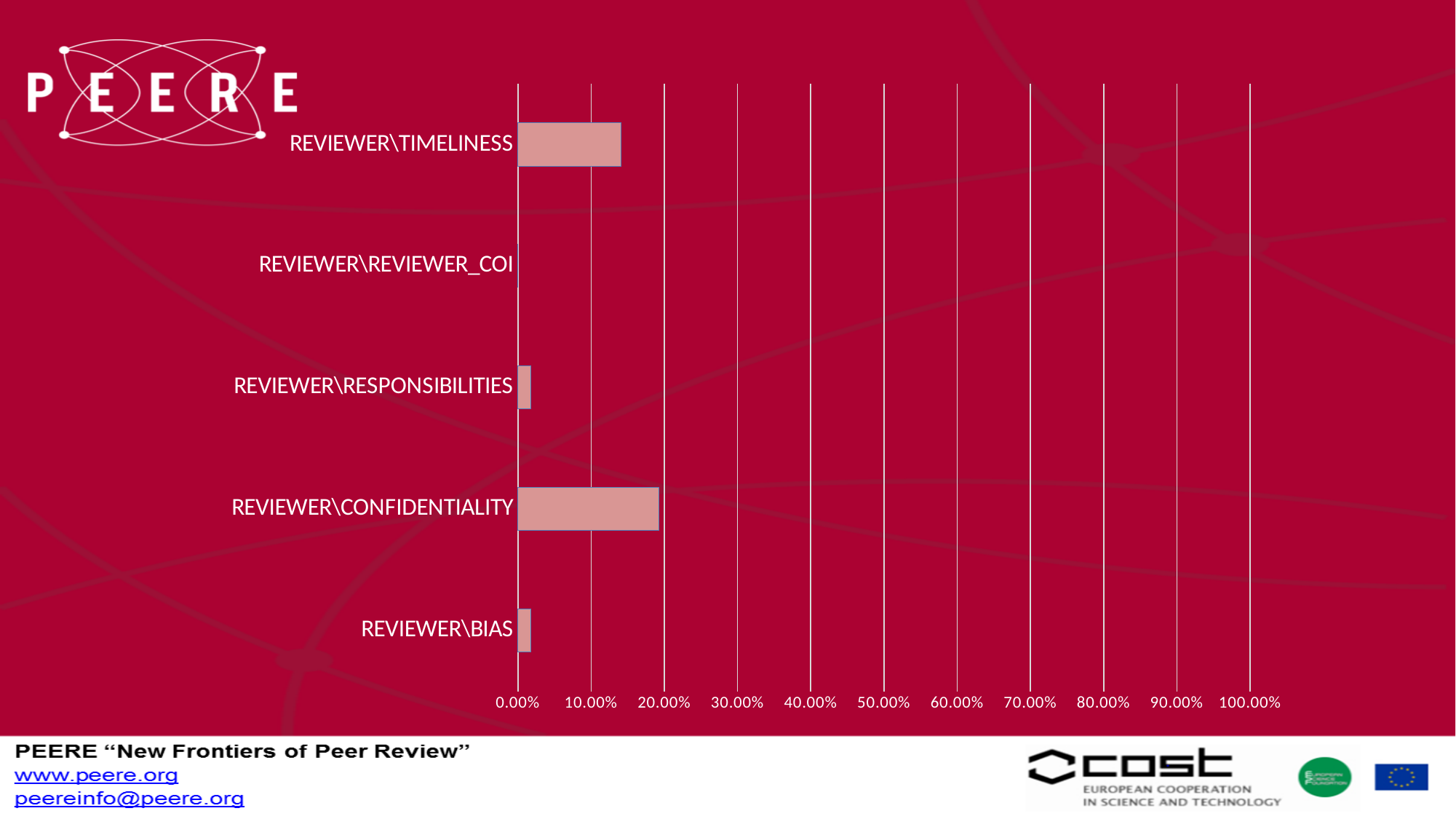
Is the value for REVIEWER\RESPONSIBILITIES greater or less than 10.00%? less Is the value for REVIEWER\BIAS greater or less than 10.00%? less Which category has the highest value? REVIEWER\CONFIDENTIALITY Which is larger, the value for REVIEWER\TIMELINESS or the value for REVIEWER\BIAS? REVIEWER\TIMELINESS Which category has the lowest value, showing no visible bar? REVIEWER\REVIEWER_COI Is the value for REVIEWER\CONFIDENTIALITY greater or less than 10.00%? greater What kind of chart is shown on the slide? bar chart Which is larger, the value for REVIEWER\CONFIDENTIALITY or the value for REVIEWER\TIMELINESS? REVIEWER\CONFIDENTIALITY How many categories are plotted on the chart? 5 What is the maximum value shown on the horizontal axis? 100.00%